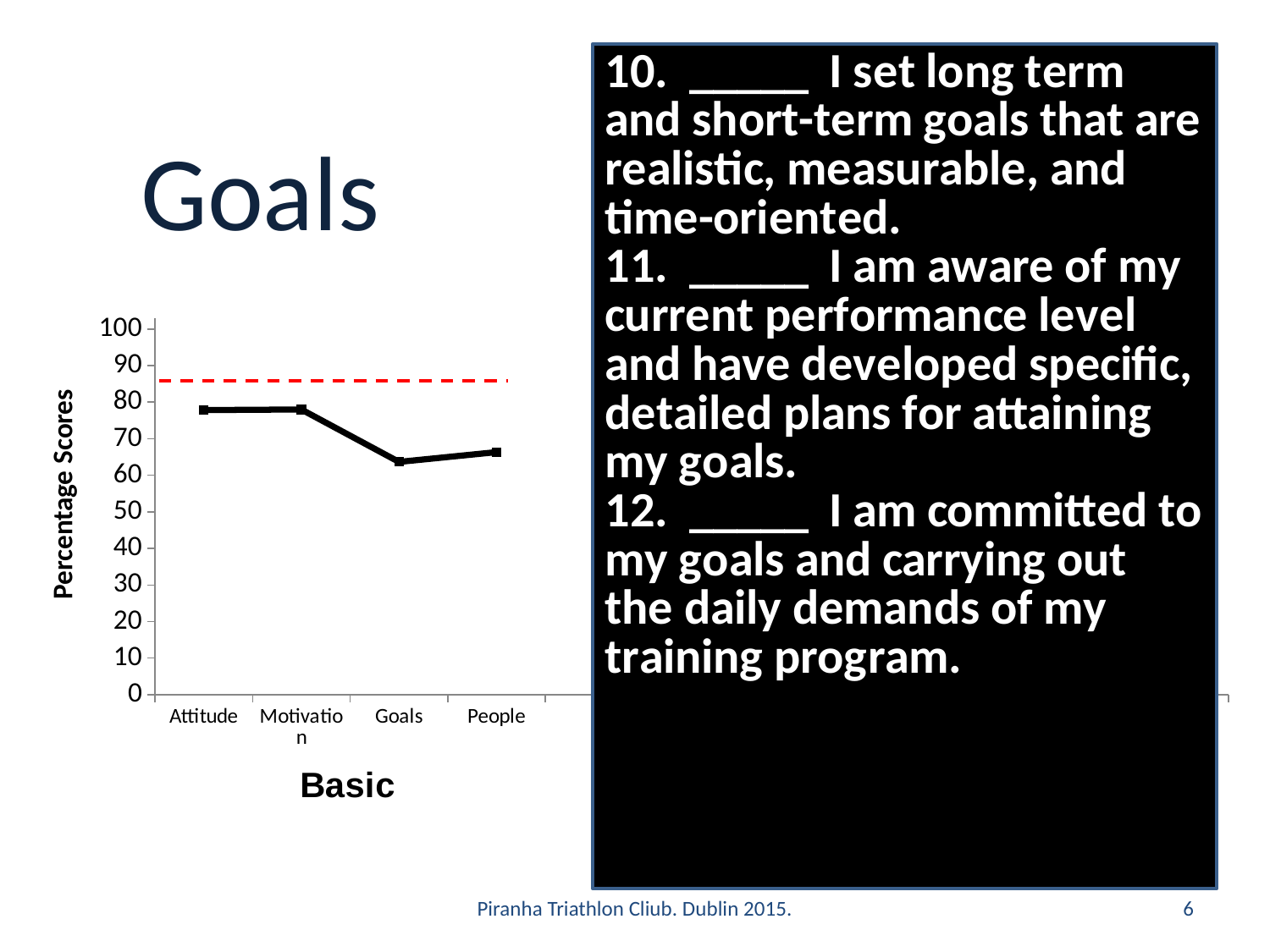
Which has the larger value, Motivation or People? Motivation What is the title of the horizontal axis? Basic Does the line rise or fall between Motivation and Goals? fall What kind of chart is shown on the slide? line chart Which has the larger value, Attitude or Goals? Attitude Is the value for Attitude greater or less than 70? greater What is the title of the vertical axis? Percentage Scores Is the value for People greater or less than 60? greater Is the value for Goals greater or less than 70? less